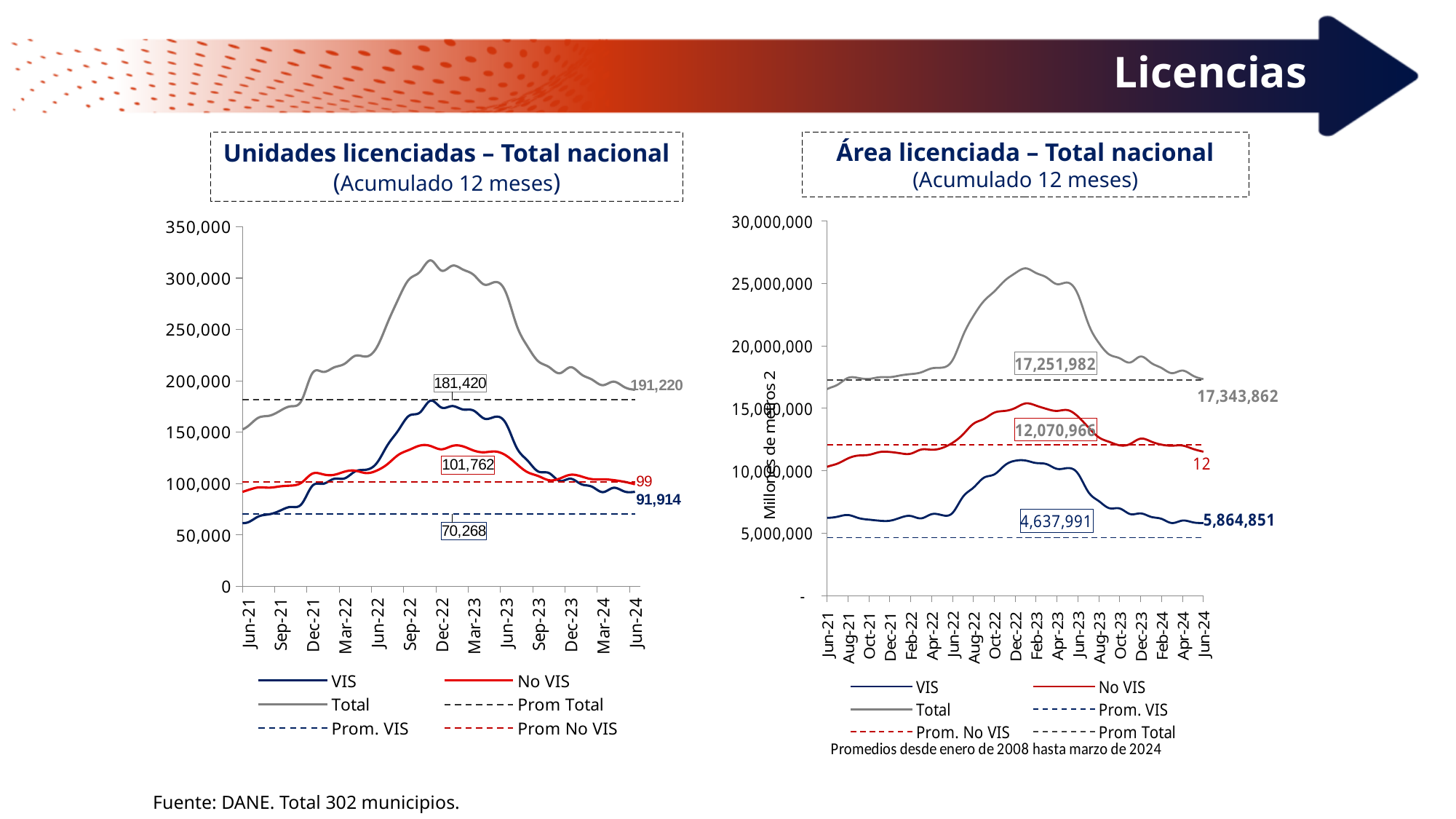
In the left chart (Unidades licenciadas – Total nacional), what is the value shown for the Prom Total line? 181,420 In the left chart (Unidades licenciadas – Total nacional), what is the VIS value labelled at Jun-24? 91,914 How many series does the legend of the left chart (Unidades licenciadas – Total nacional) list? 6 In the right chart (Área licenciada – Total nacional), what is the value shown for the Prom. VIS line? 4,637,991 In the left chart (Unidades licenciadas – Total nacional), what is the difference between the Prom Total value and the Prom. VIS value? 111,152 In the left chart (Unidades licenciadas – Total nacional), what is the Total value labelled at Jun-24? 191,220 In the right chart (Área licenciada – Total nacional), what is the VIS value labelled at Jun-24? 5,864,851 In the left chart (Unidades licenciadas – Total nacional), what is the value shown for the Prom No VIS line? 101,762 In the right chart (Área licenciada – Total nacional), which is larger: the Total value at Jun-24 (17,343,862) or the Prom Total value (17,251,982)? Total at Jun-24 In the right chart (Área licenciada – Total nacional), what is the value shown for the Prom Total line? 17,251,982 In the left chart (Unidades licenciadas – Total nacional), what is the value shown for the Prom. VIS line? 70,268 In the left chart (Unidades licenciadas – Total nacional), is the peak of the Total line greater or less than 300,000? greater